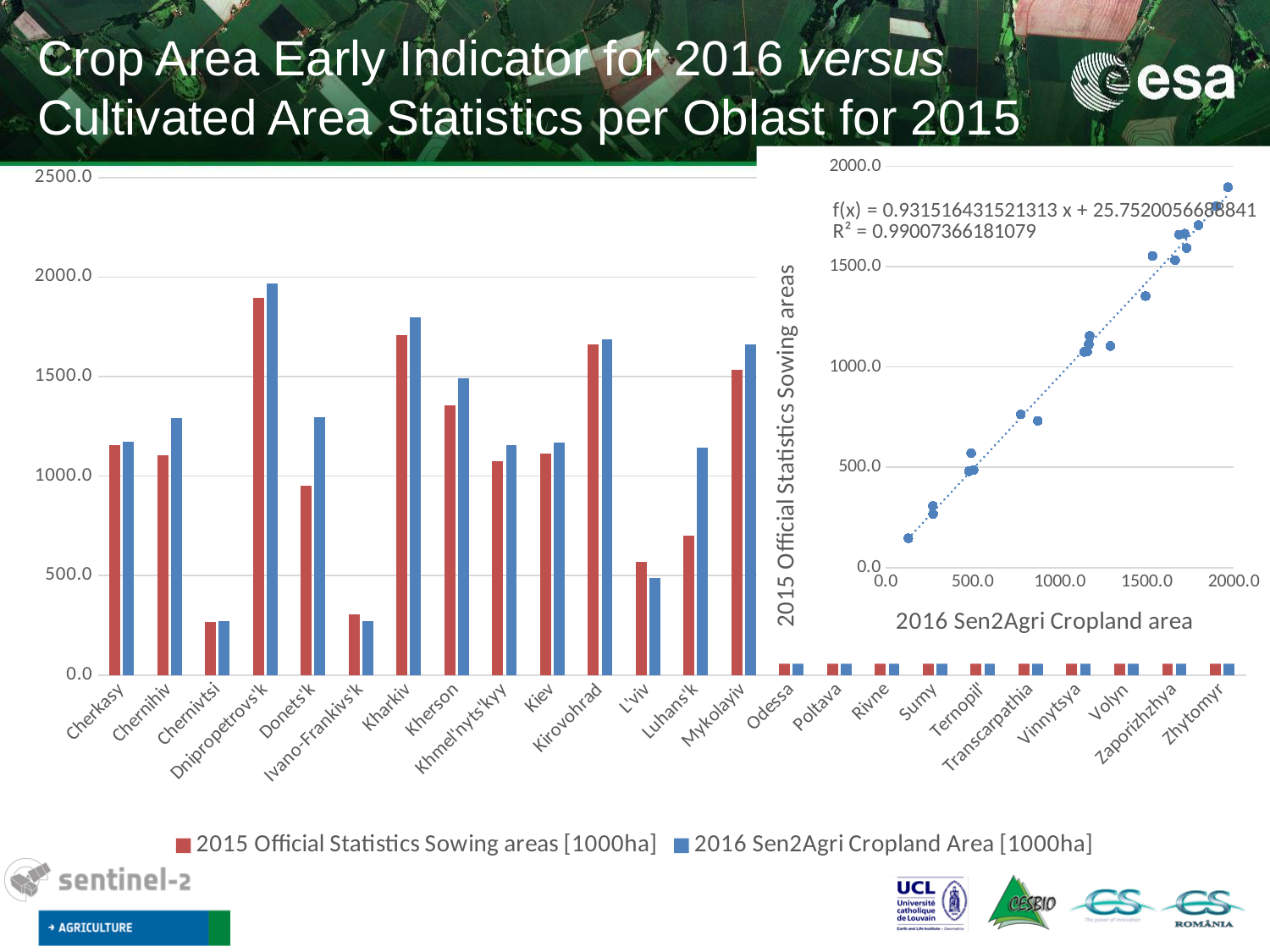
In the bar chart, which is larger for L'viv: the 2015 Official Statistics Sowing areas or the 2016 Sen2Agri Cropland Area? 2015 Official Statistics Sowing areas How many oblasts are shown on the x axis of the bar chart? 24 In the scatter chart, do the points rise or fall as the 2016 Sen2Agri Cropland area increases? rise In the scatter chart, what R² value is printed for the trend line? R² = 0.99007366181079 In the bar chart, is the 2015 Official Statistics Sowing areas value for Cherkasy greater or less than 1000.0? greater How many series does the legend of the bar chart list? 2 In the bar chart, is the 2016 Sen2Agri Cropland Area value for Kharkiv greater or less than 1500.0? greater In the bar chart, among the oblasts from Cherkasy to Mykolayiv, which has the tallest 2016 Sen2Agri Cropland Area bar? Dnipropetrovs'k In the bar chart, is the 2015 Official Statistics Sowing areas value for Chernivtsi greater or less than 500.0? less What kind of chart is the smaller chart inset on the right of the slide? scatter chart In the bar chart, which is larger for Luhans'k: the 2015 Official Statistics Sowing areas or the 2016 Sen2Agri Cropland Area? 2016 Sen2Agri Cropland Area What kind of chart is the large chart on the left of the slide? bar chart